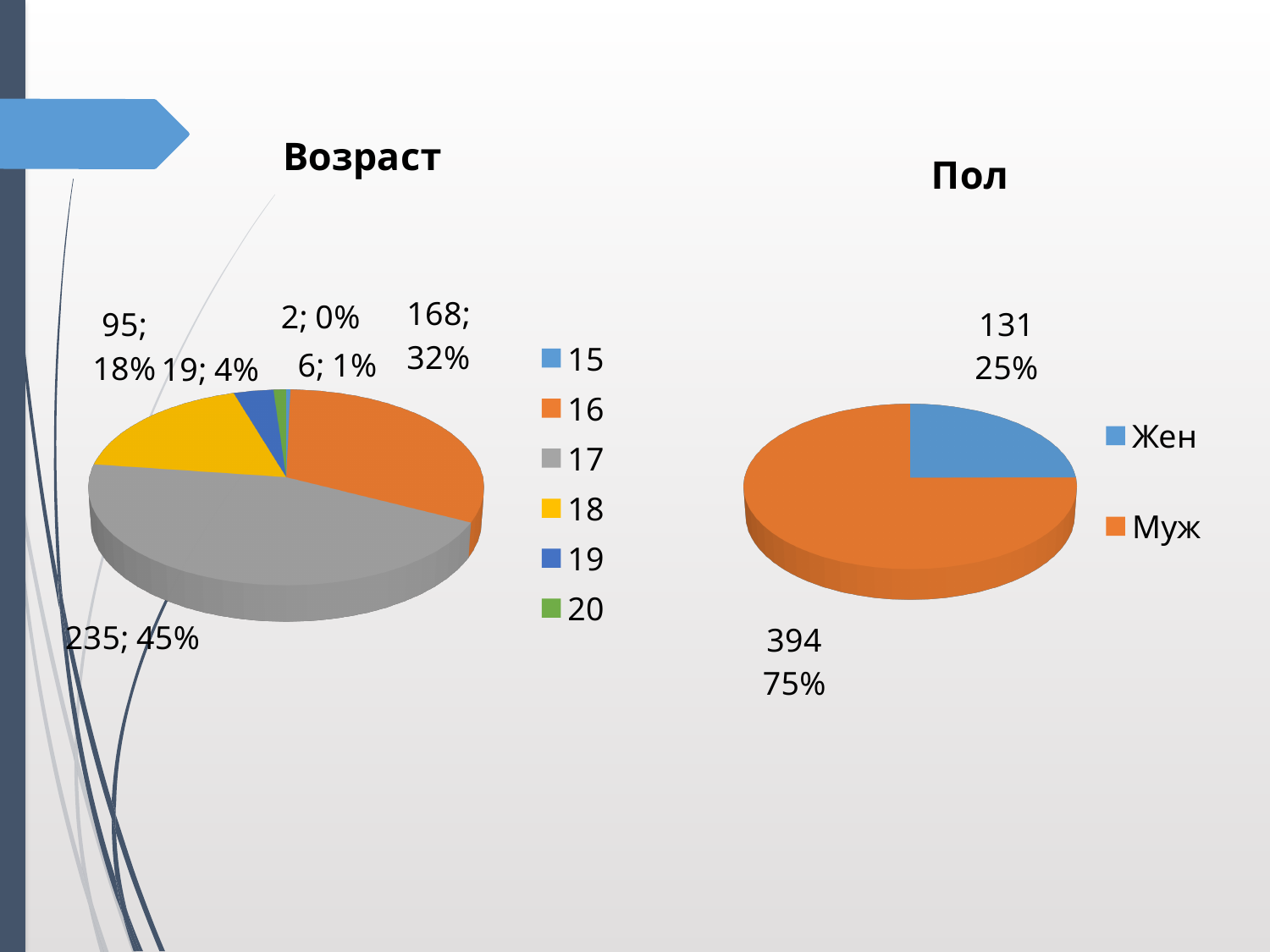
In the "Возраст" chart, which is larger, the value for age 18 or the value for age 19? 18 In the "Возраст" chart, what is the difference between the values for age 17 and age 16? 67 In the "Возраст" chart, how many categories does the legend list? 6 What type of chart is the "Пол" chart? Pie chart In the "Пол" chart, what value and share are shown for Муж? 394; 75% In the "Возраст" chart, which age has the largest slice? 17 In the "Возраст" chart, what value and share are shown for age 18? 95; 18% In the "Пол" chart, what is the total of the two slices? 525 In the "Возраст" chart, what value and share are shown for age 17? 235; 45% In the "Возраст" chart, what value and share are shown for age 16? 168; 32% In the "Пол" chart, what value and share are shown for Жен? 131; 25% In the "Возраст" chart, what value and share are shown for age 19? 19; 4%